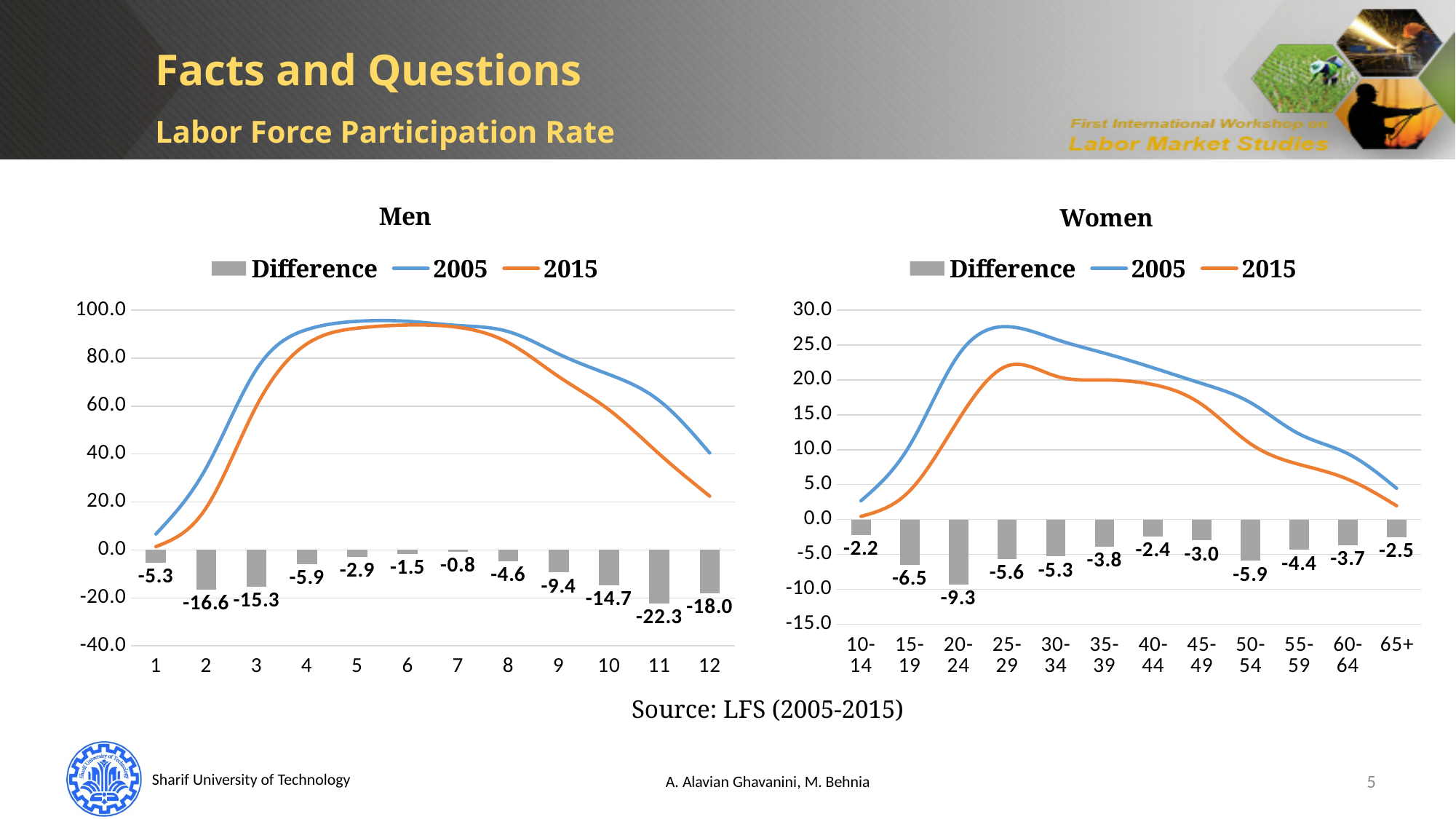
In the Men chart, what is the difference between the Difference values for category 2 and category 3? 1.3 In the Women chart, is the 2015 value for the 25-29 age group greater or less than 25.0? less In the Women chart, does the 2005 line rise or fall from the 25-29 group to the 65+ group? fall In the Men chart, what is the Difference value for category 11? -22.3 In the Men chart, is the 2005 value for category 12 greater or less than 20.0? greater How many age groups are shown on the x axis of the Women chart? 12 In the Women chart, which age group has the lowest Difference value? 20-24 How many series does the legend of the Men chart list? 3 In the Men chart, which category has the lowest Difference value? 11 In the Women chart, what is the Difference value for the 20-24 age group? -9.3 In the Women chart, which has a larger Difference value, the 35-39 group or the 50-54 group? 35-39 In the Women chart, which age group has the highest (least negative) Difference value? 10-14